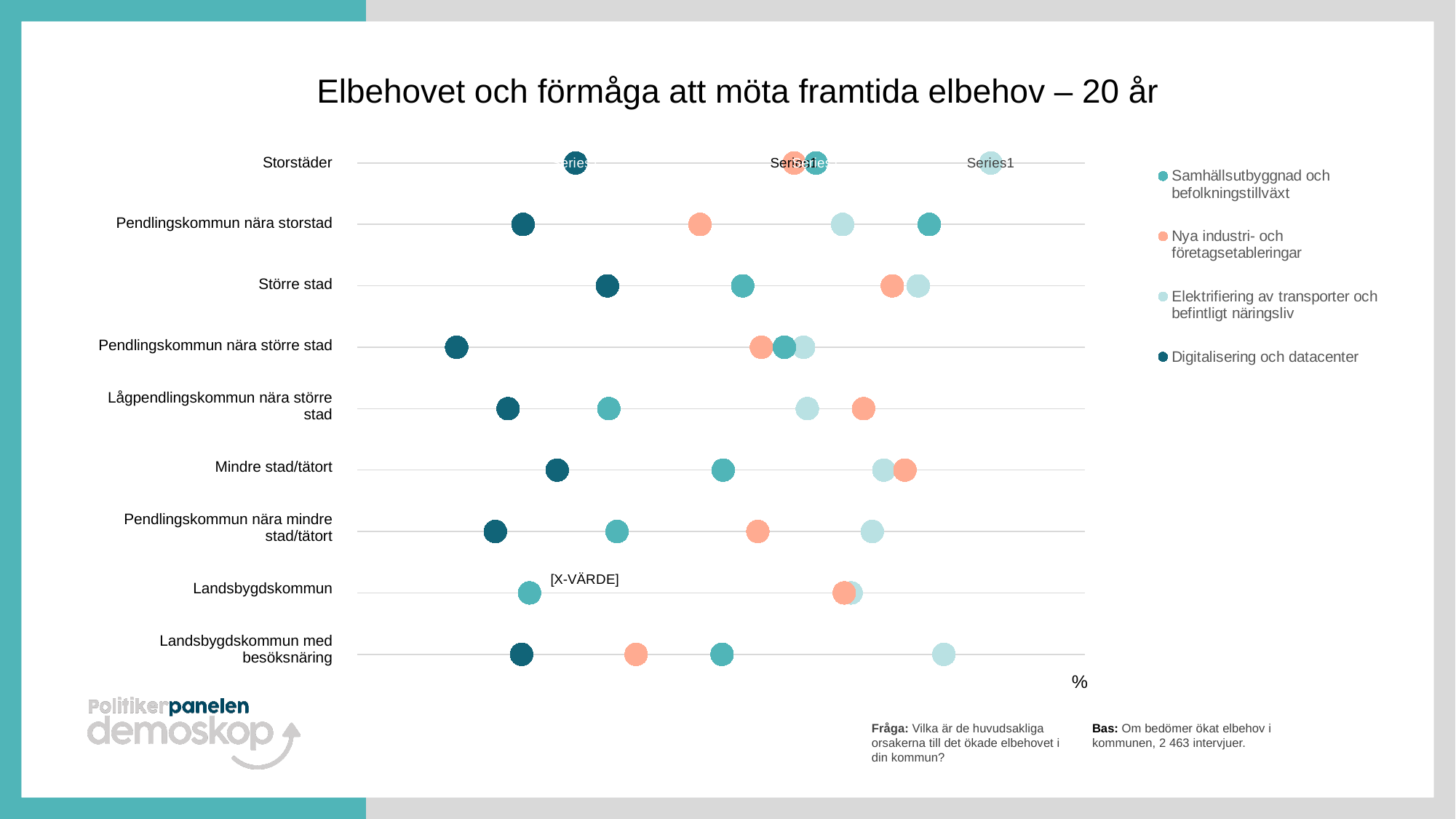
How many series does the legend list? 4 For Landsbygdskommun med besöksnäring, which series has the highest value? Elektrifiering av transporter och befintligt näringsliv What kind of chart is shown on the slide? Scatter (dot) chart For Pendlingskommun nära storstad, which series has the lowest value? Digitalisering och datacenter For Storstäder, which series has the lowest value? Digitalisering och datacenter How many municipality categories are listed on the vertical axis? 9 What is the title of the chart? Elbehovet och förmåga att möta framtida elbehov – 20 år For Större stad, which is larger: Nya industri- och företagsetableringar or Samhällsutbyggnad och befolkningstillväxt? Nya industri- och företagsetableringar For Lågpendlingskommun nära större stad, which series has the highest value? Nya industri- och företagsetableringar Which category has the lowest value for Digitalisering och datacenter? Pendlingskommun nära större stad Which series is shown with the dark navy dots? Digitalisering och datacenter For Pendlingskommun nära storstad, which series has the highest value? Samhällsutbyggnad och befolkningstillväxt